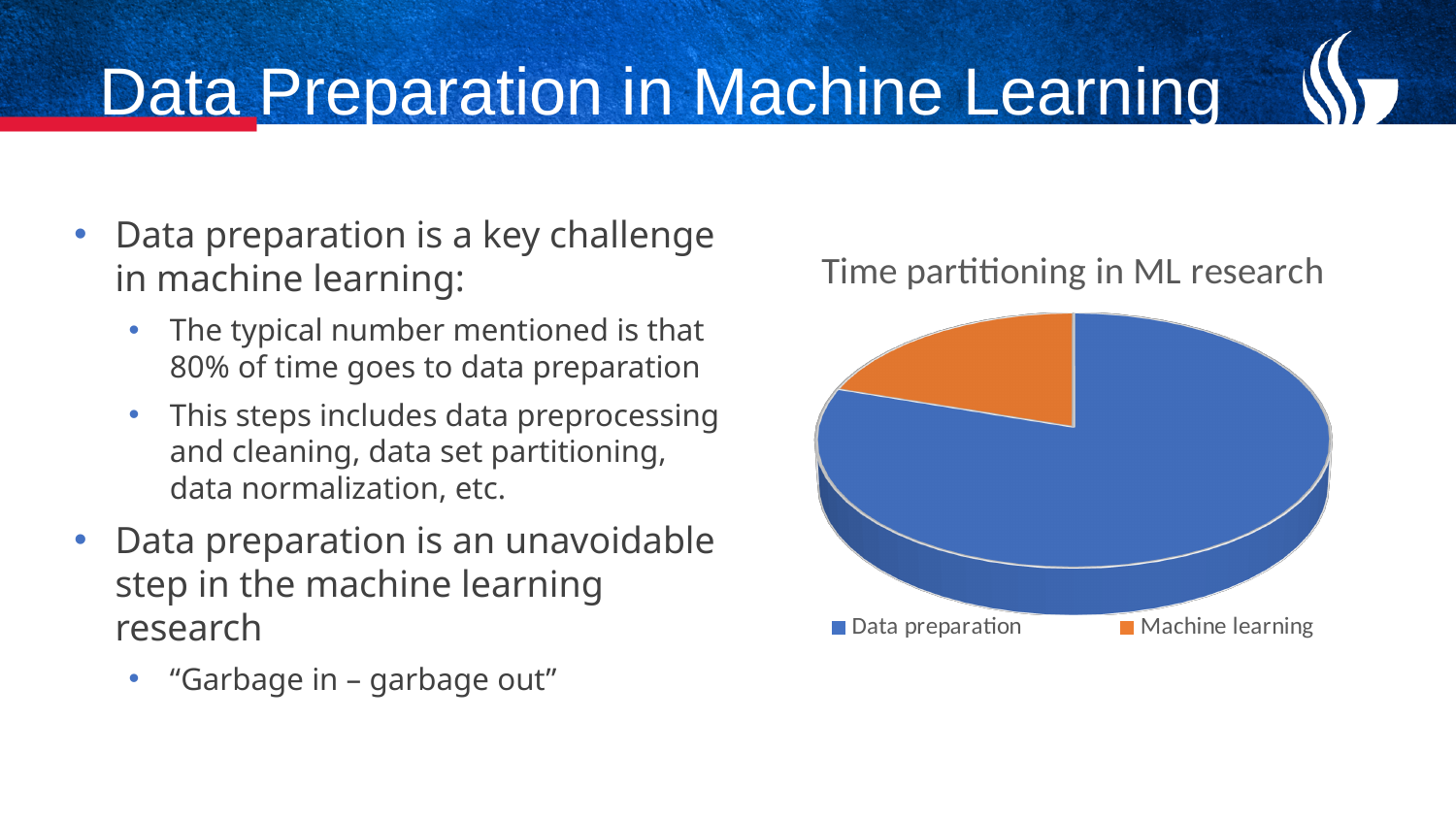
Which slice is larger, Data preparation or Machine learning? Data preparation Which category has the largest slice of the pie? Data preparation Which category has the smallest slice of the pie? Machine learning What colour is the Machine learning slice in the pie chart? Orange How many slices does the pie chart have? 2 What kind of chart is shown on the slide? Pie chart How many entries does the chart legend list? 2 What is the title of the chart? Time partitioning in ML research